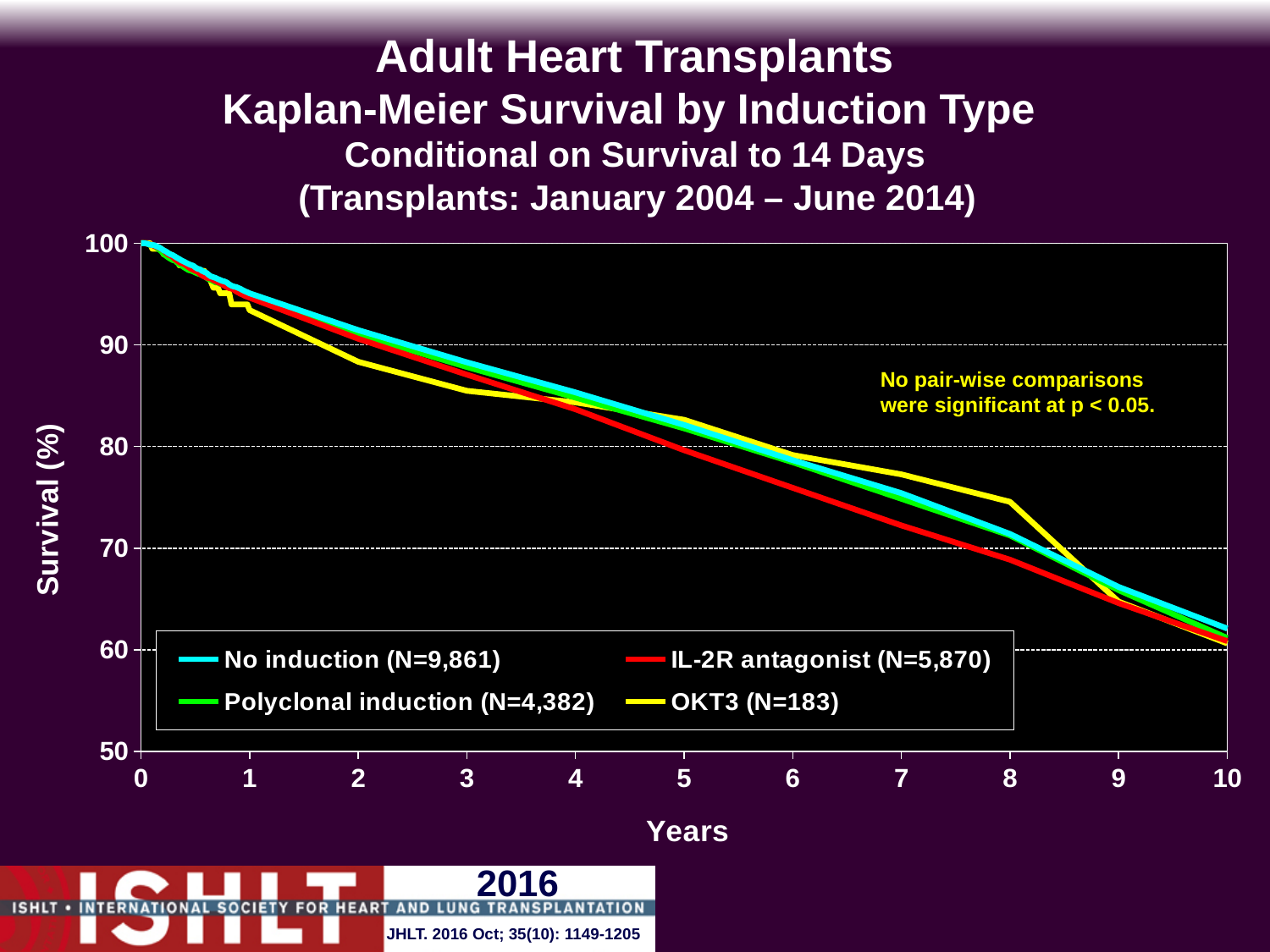
How many series does the legend list? 4 Is the survival value for OKT3 at year 2 greater or less than 90? less Which induction type has the highest survival at year 7? OKT3 At year 8, which has higher survival: OKT3 or IL-2R antagonist? OKT3 What is the N shown in the legend for the No induction group? N=9,861 What kind of chart is shown on the slide? line chart Is the survival value for OKT3 at year 8 greater or less than 70? greater Which induction type has the lowest survival at year 6? IL-2R antagonist Do the survival curves rise or fall as years increase along the x axis? fall Is the survival value for No induction at year 10 greater or less than 60? greater At year 2, which has higher survival: No induction or OKT3? No induction